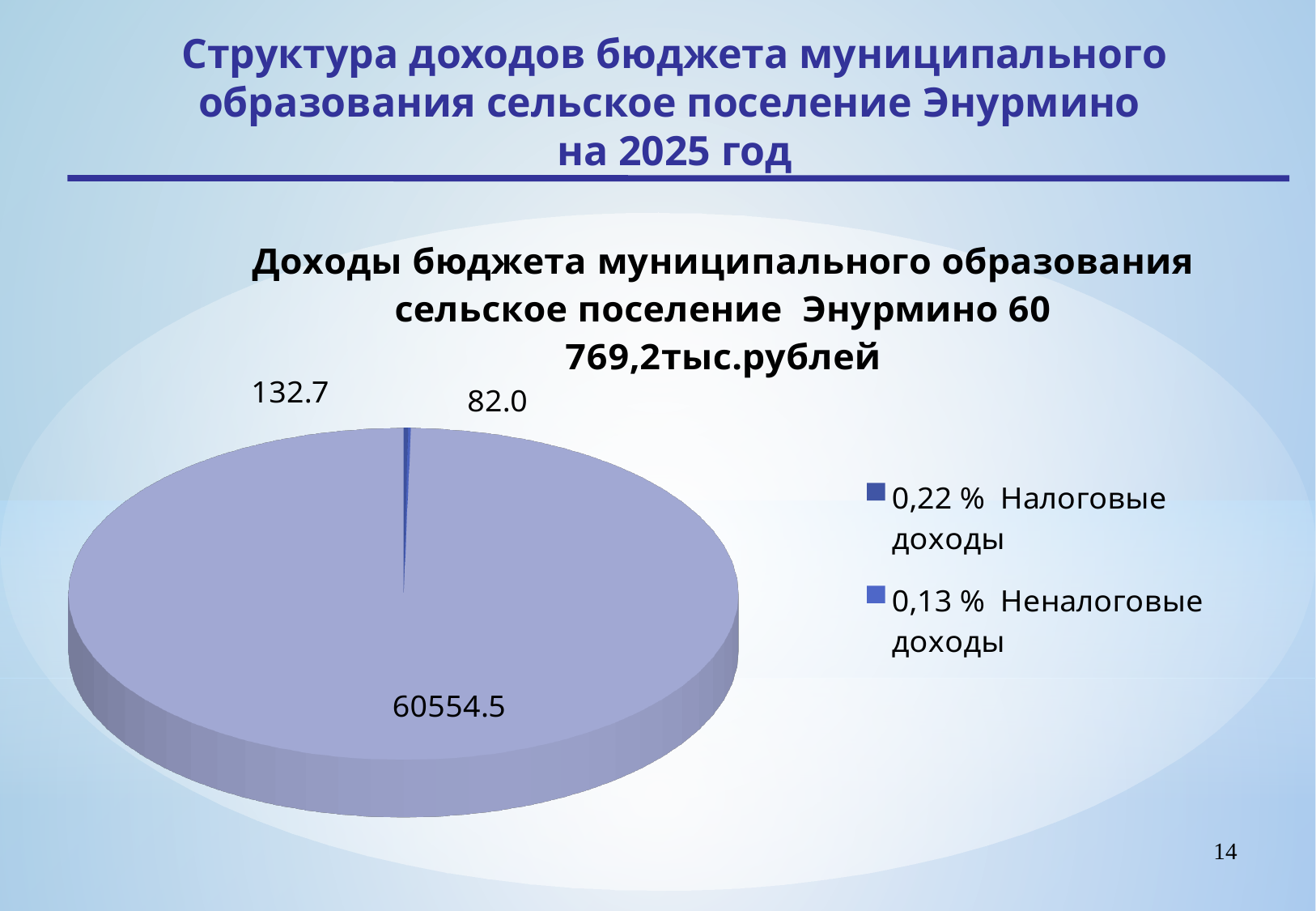
How many entries does the legend of the pie chart list? 2 How many data labels (slices) are shown on the pie chart? 3 What total budget revenue amount is stated in the chart title? 60 769,2тыс.рублей What percentage share is given in the legend for Неналоговые доходы? 0,13 % Is the largest slice value on the pie chart greater or less than 60000? greater Which year does the slide title say the budget revenue structure refers to? 2025 What is the difference between the two small slice values 132.7 and 82.0 on the pie chart? 50.7 What is the smallest value labelled on the pie chart? 82.0 Which labelled value on the pie chart is larger, 132.7 or 82.0? 132.7 What kind of chart is shown on the slide? Pie chart What percentage share is given in the legend for Налоговые доходы? 0,22 % What is the largest value labelled on the pie chart? 60554.5